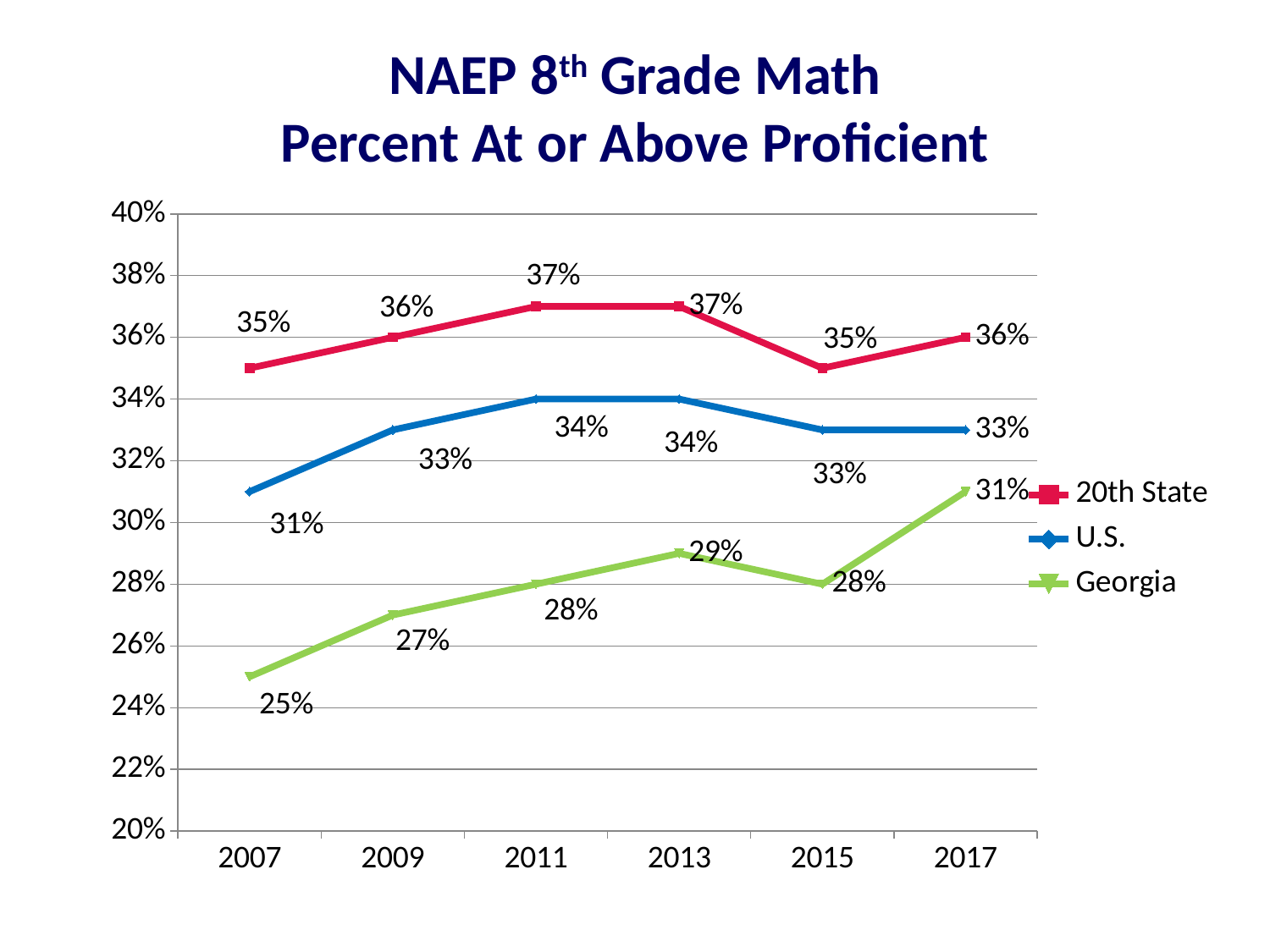
What kind of chart is this? line chart Which is larger in 2013: the U.S. value or the Georgia value? U.S. How many years are shown on the x axis? 6 How many series does the legend list? 3 What is the value for the 20th State series in 2011? 37% What is the value for Georgia in 2007? 25% In which year is the U.S. value lowest? 2007 Does the Georgia value rise or fall from 2007 to 2013? rise Is the Georgia value in 2009 greater or less than 30%? less What is the difference between the 20th State value and the Georgia value in 2017? 5% What is the value for U.S. in 2015? 33% In which year is the Georgia value highest? 2017